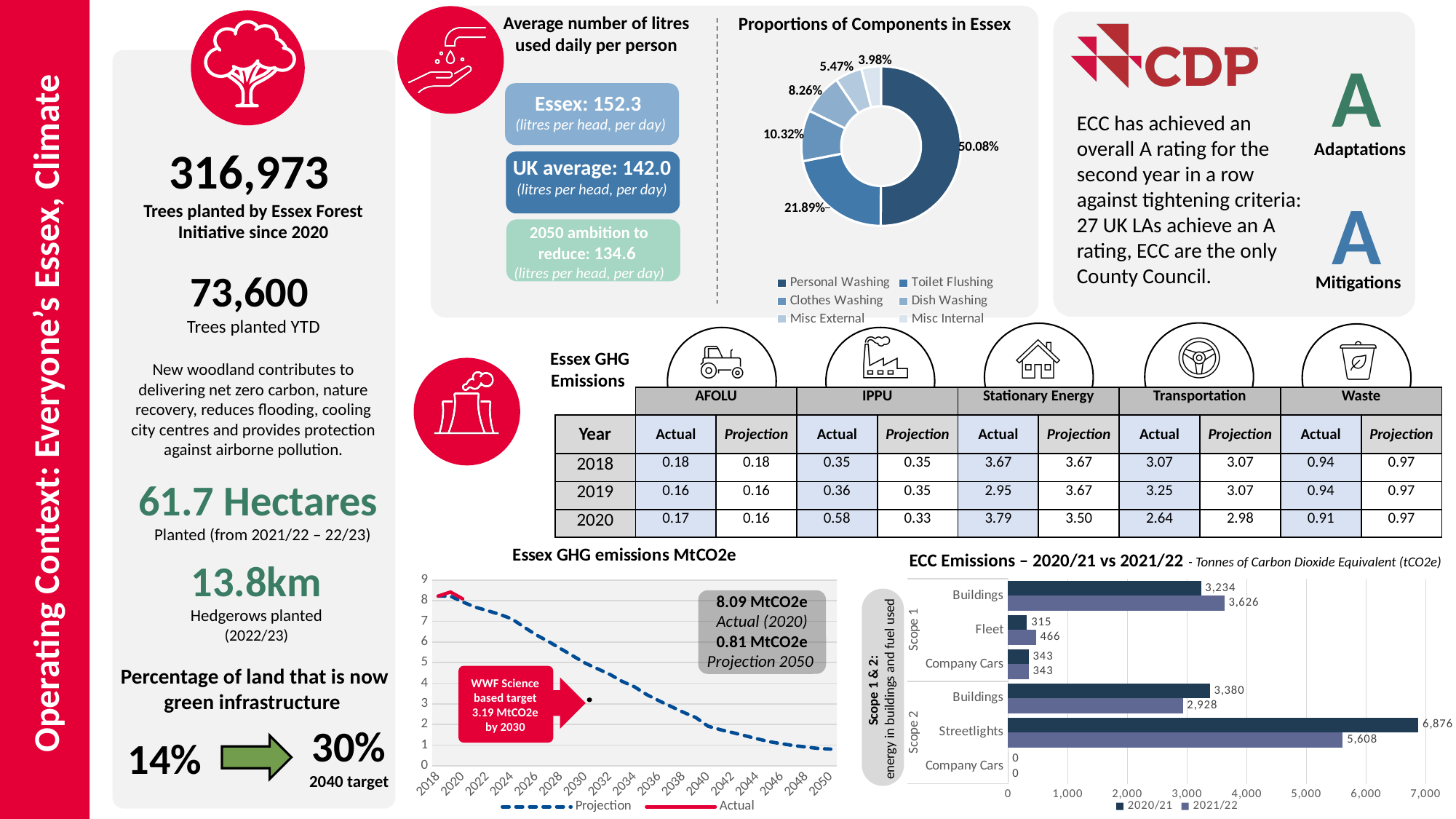
How many components does the legend of the 'Proportions of Components in Essex' chart list? 6 In the 'Proportions of Components in Essex' chart, what percentage is shown for Personal Washing? 50.08% In the 'ECC Emissions – 2020/21 vs 2021/22' chart, what is the 2020/21 value for Scope 2 Streetlights? 6,876 In the 'ECC Emissions – 2020/21 vs 2021/22' chart, what is the difference between the 2020/21 and 2021/22 values for Scope 1 Buildings? 392 In the 'Essex GHG emissions MtCO2e' chart, does the projection line rise or fall from 2020 to 2050? Fall In the 'ECC Emissions – 2020/21 vs 2021/22' chart, what is the 2021/22 value for Scope 1 Fleet? 466 In the 'ECC Emissions – 2020/21 vs 2021/22' chart, is the 2021/22 value for Scope 2 Buildings larger or smaller than the 2020/21 value? Smaller What type of chart is 'Proportions of Components in Essex'? Donut (pie) chart In the 'Proportions of Components in Essex' chart, which component has the smallest share? Misc Internal How many series does the legend of the 'ECC Emissions – 2020/21 vs 2021/22' chart list? 2 In the 'ECC Emissions – 2020/21 vs 2021/22' chart, which category has the highest value in 2020/21? Streetlights (Scope 2) In the 'Essex GHG emissions MtCO2e' chart, what is the projected value for 2050? 0.81 MtCO2e